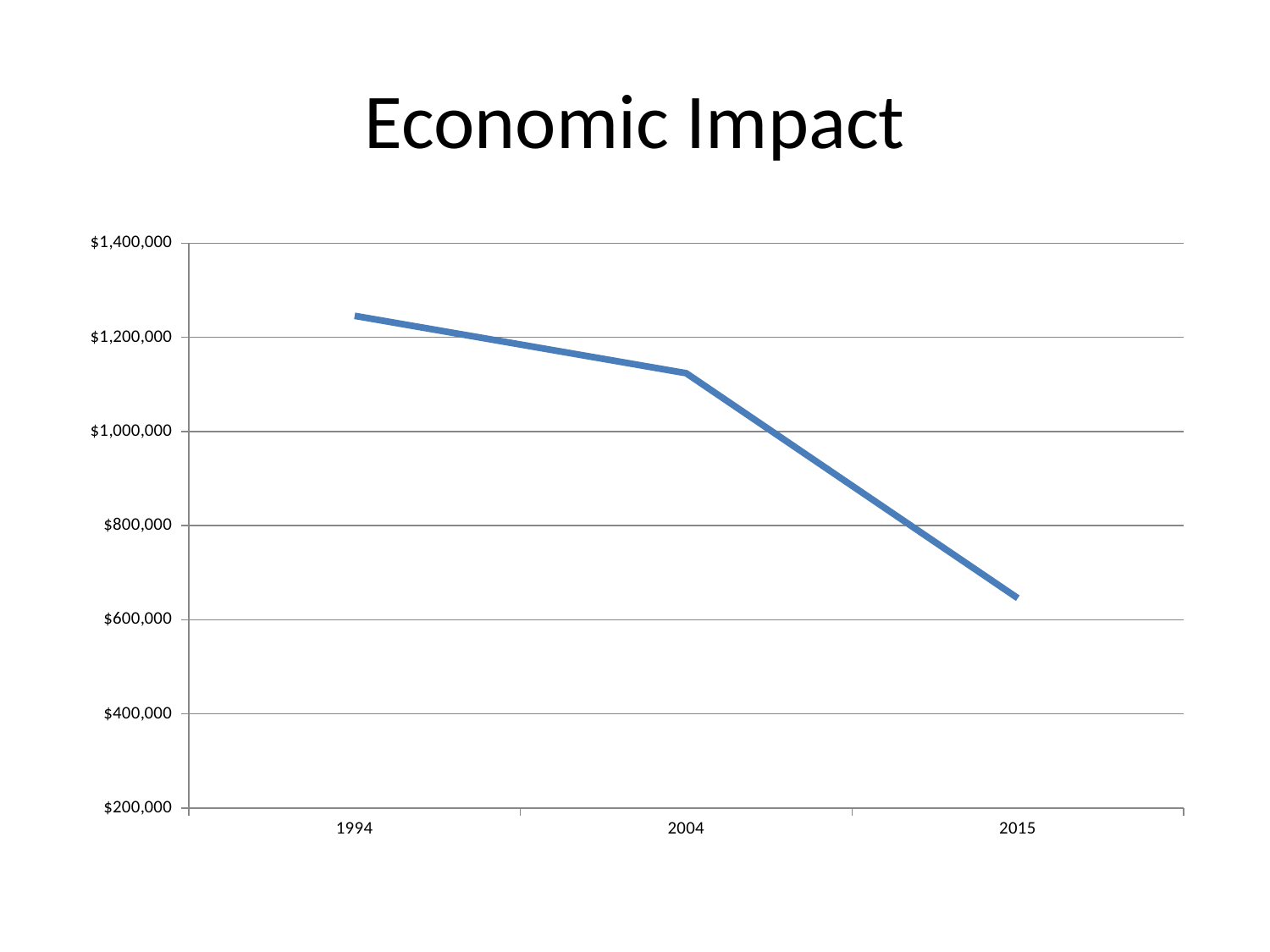
How many years are plotted on the x axis? 3 Do the values rise or fall from 1994 to 2015? fall Which year has the highest value? 1994 What kind of chart is shown on the slide? line chart Is the value for 2015 greater or less than $600,000? greater Is the value for 2015 greater or less than $800,000? less Which year has the lowest value? 2015 Is the value for 2004 greater or less than $1,200,000? less Which is larger, the value for 2004 or the value for 2015? 2004 What is the title of the chart? Economic Impact